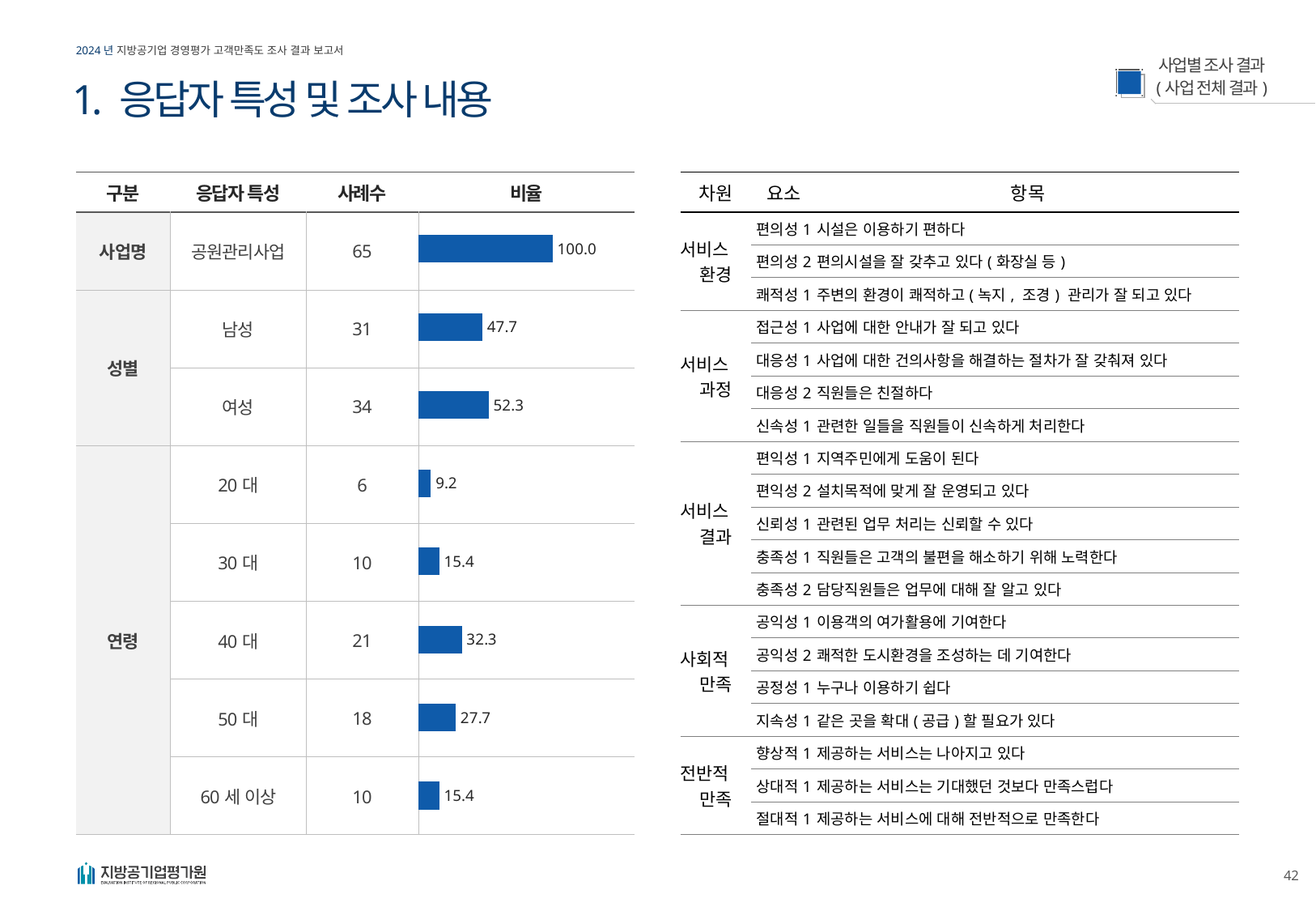
What is the difference between the 비율 values for 여성 and 남성? 4.6 How many 연령 (age) categories have bars in the chart? 6 What kind of chart is used in the 비율 column? bar chart Among the 연령 (age) groups, which has the highest 비율 bar? 40 대 What is the difference between the 비율 values for 40 대 and 50 대? 4.6 What is the 비율 value shown for 40 대 in the bar chart? 32.3 What is the 비율 value shown for 남성 in the bar chart? 47.7 What is the 비율 value shown for 60 세 이상 in the bar chart? 15.4 Which has a larger 비율 value, 50 대 or 30 대? 50 대 Which has a larger 비율 value, 남성 or 여성? 여성 Among the 연령 (age) groups, which has the lowest 비율 bar? 20 대 What colour are the bars in the 비율 chart? blue